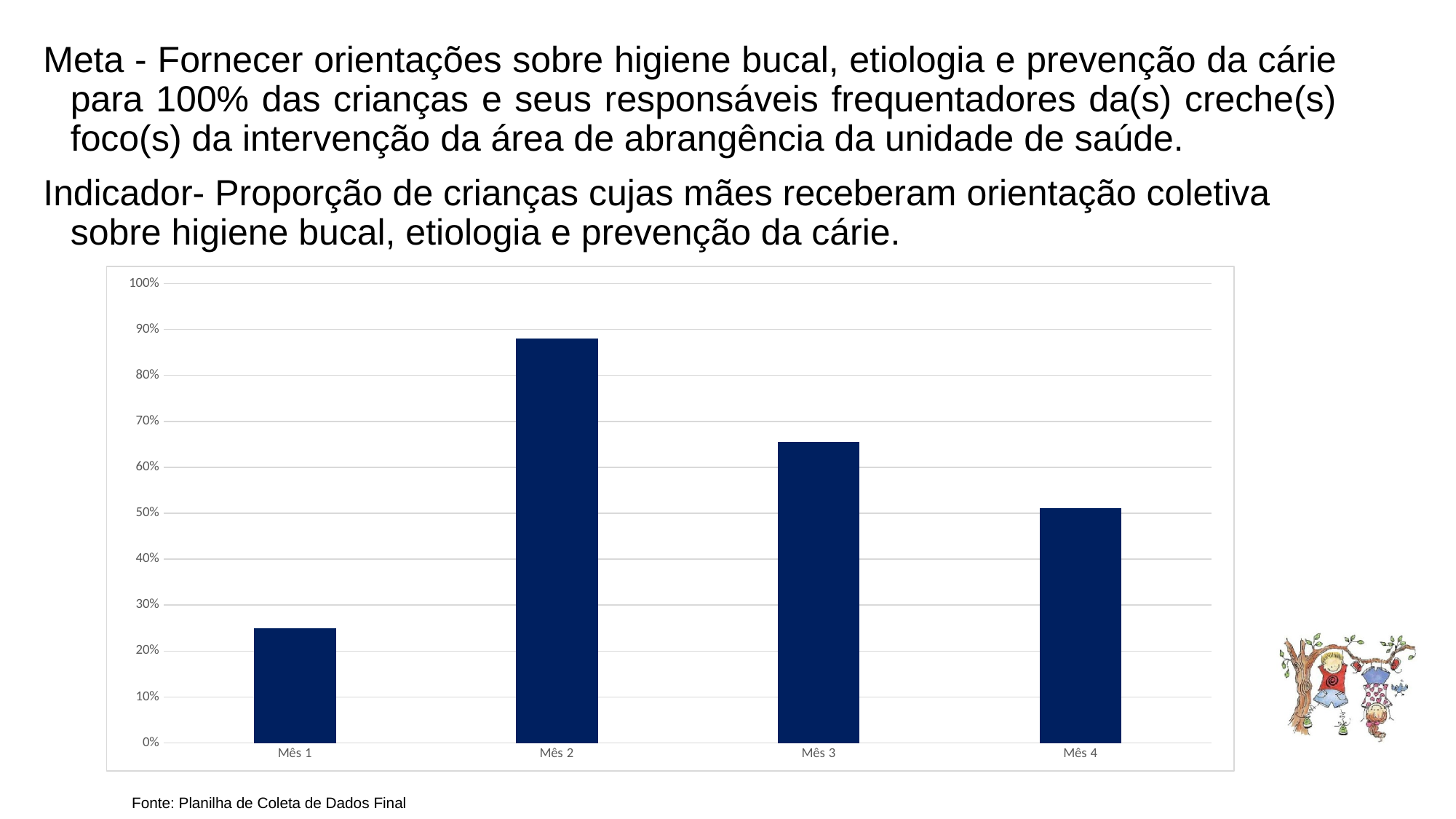
What kind of chart is shown on the slide? bar chart Is the value for Mês 2 greater or less than 80%? greater Does the value rise or fall from Mês 2 to Mês 4? fall Which month has the highest bar on the chart? Mês 2 Is the value for Mês 3 greater or less than 60%? greater How many months (categories) are plotted on the chart? 4 Does the value rise or fall from Mês 1 to Mês 2? rise Which month has the lowest bar on the chart? Mês 1 Which is larger, the value for Mês 3 or the value for Mês 4? Mês 3 What source is cited below the chart? Planilha de Coleta de Dados Final Is the value for Mês 4 greater or less than 40%? greater